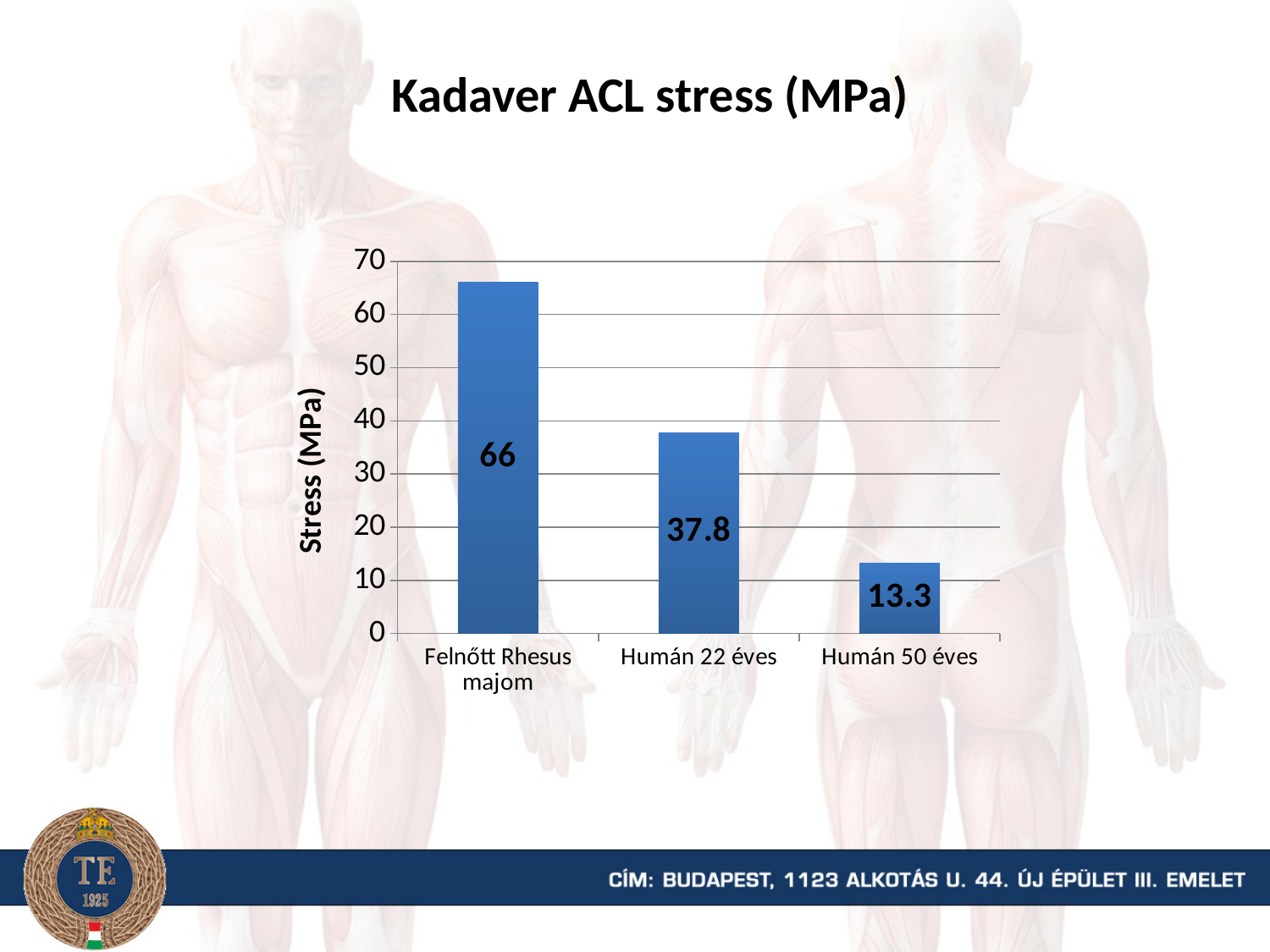
How many categories are shown on the chart? 3 What kind of chart is shown on the slide? bar chart Which category has the lowest stress value? Humán 50 éves What is the difference between the stress values for Humán 22 éves and Humán 50 éves? 24.5 What is the stress value for Felnőtt Rhesus majom? 66 What is the stress value for Humán 50 éves? 13.3 What is the title of the chart? Kadaver ACL stress (MPa) Is the value for Humán 22 éves greater or less than 40? less What is the stress value for Humán 22 éves? 37.8 What is the difference between the stress values for Felnőtt Rhesus majom and Humán 22 éves? 28.2 Which category has the highest stress value? Felnőtt Rhesus majom Which is larger, the stress value for Humán 22 éves or for Humán 50 éves? Humán 22 éves